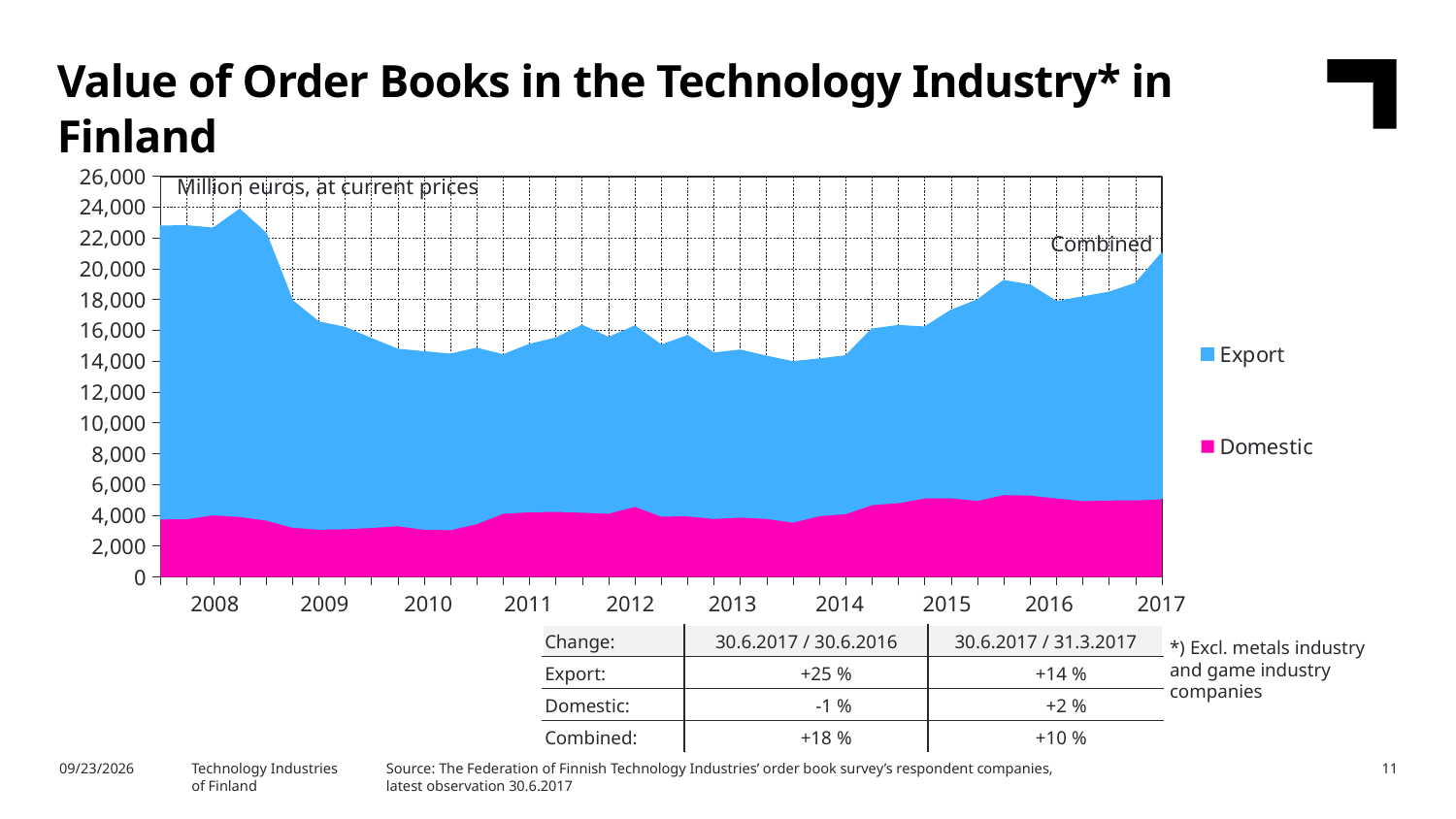
Is the combined value of order books larger in 2008 or in 2014? 2008 Is the combined value of order books at the 2014 tick greater or less than 16,000? less Is the Domestic value at the 2017 end of the chart greater or less than 4,000? greater What unit is stated in the label at the top of the chart area? Million euros, at current prices Does the combined value of order books rise or fall between 2014 and 2017? rise How many series does the chart's legend list? 2 Does the combined value of order books rise or fall between 2008 and 2010? fall Which two series are listed in the chart's legend? Export and Domestic Is the Domestic value at any point on the chart greater or less than 6,000? less Which series is larger throughout the chart, Export or Domestic? Export What kind of chart is shown on the slide? Area chart